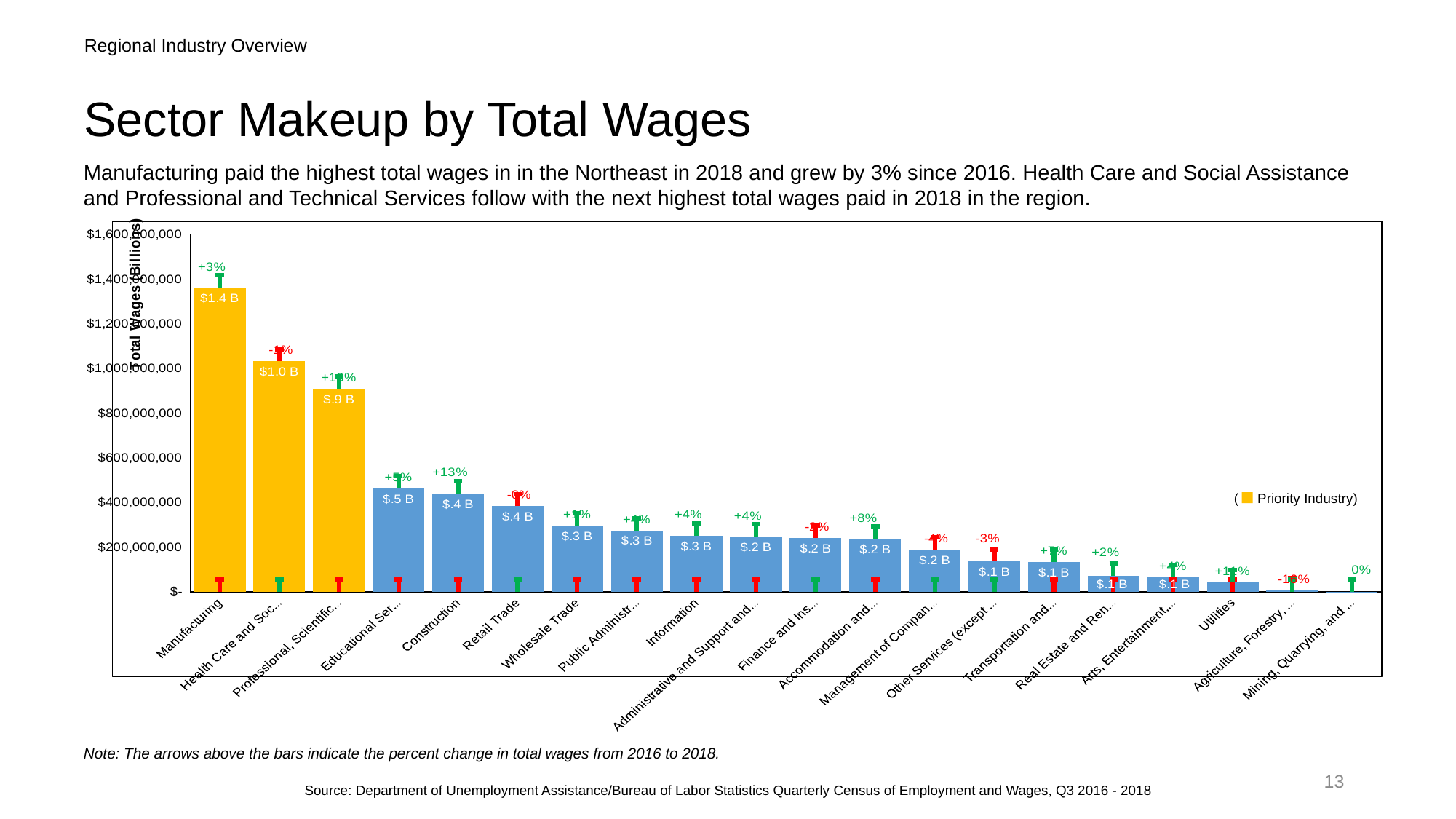
Which sector has the highest total wages? Manufacturing How many sectors are shown on the x axis? 20 Which has higher total wages, Educational Services or Retail Trade? Educational Services Which has higher total wages, Manufacturing or Health Care and Social Assistance? Manufacturing Is the value for Manufacturing greater or less than $1,200,000,000? greater Is the value for Educational Services greater or less than $600,000,000? less What percent change in total wages is shown above the Manufacturing bar? +3% What kind of chart is shown? bar chart What percent change in total wages is shown above the Construction bar? +13% What is the total wages value shown for Manufacturing? $1.4 B Do the bar values rise or fall from left to right along the x axis? fall What is the total wages value shown for Construction? $.4 B